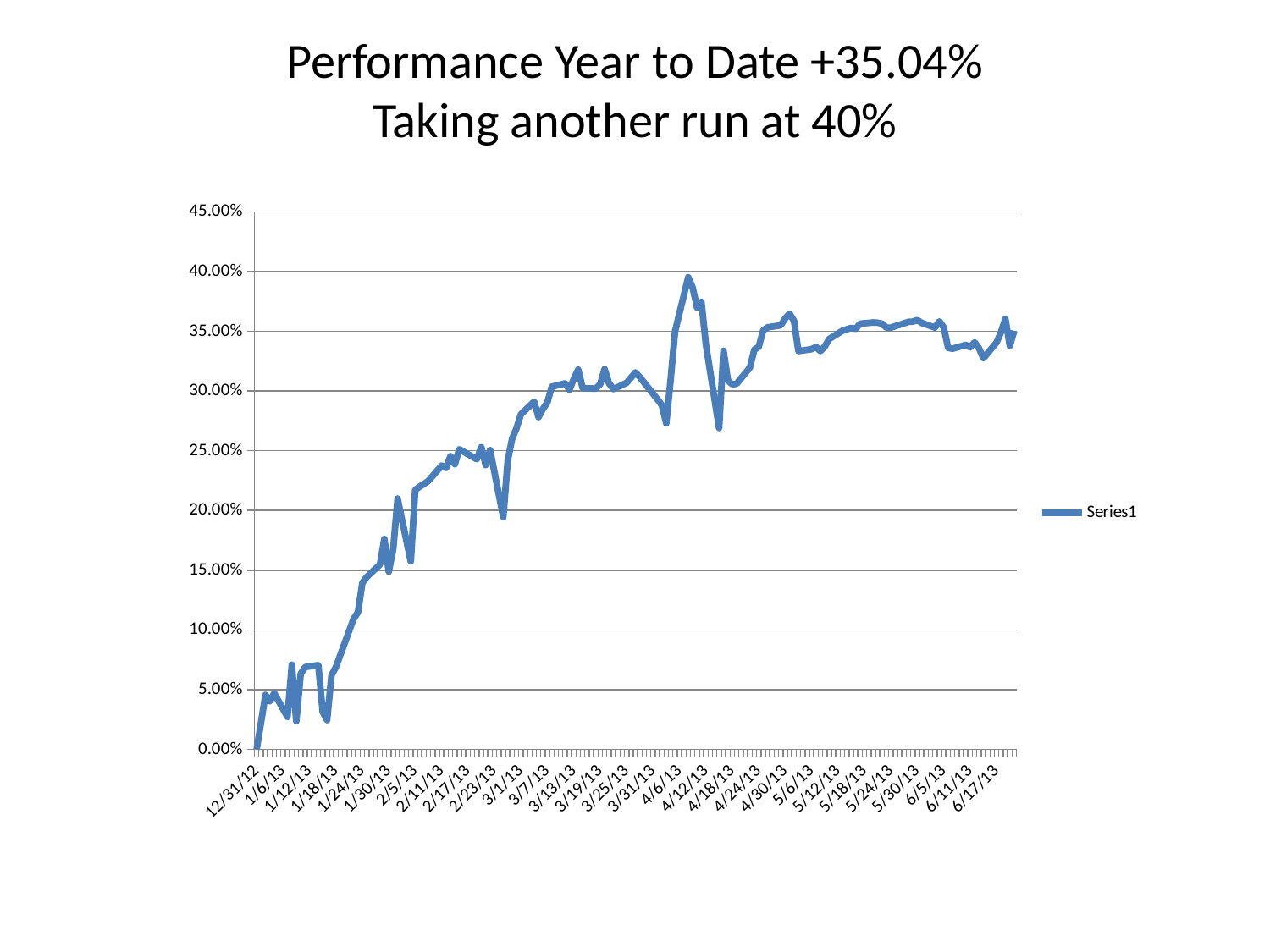
What is the highest value shown on the y axis? 45.00% What kind of chart is shown on the slide? line chart Is the value for 3/13/13 greater or less than 25%? greater Is the value for 1/6/13 greater or less than 10%? less How many series does the legend list? 1 What is the name of the series shown in the legend? Series1 Is the value for 6/17/13 greater or less than 30%? greater What is the title of the chart on the slide? Performance Year to Date +35.04% Taking another run at 40% What is the first date label shown on the x axis? 12/31/12 Overall, do the values rise or fall from left to right along the x axis? rise